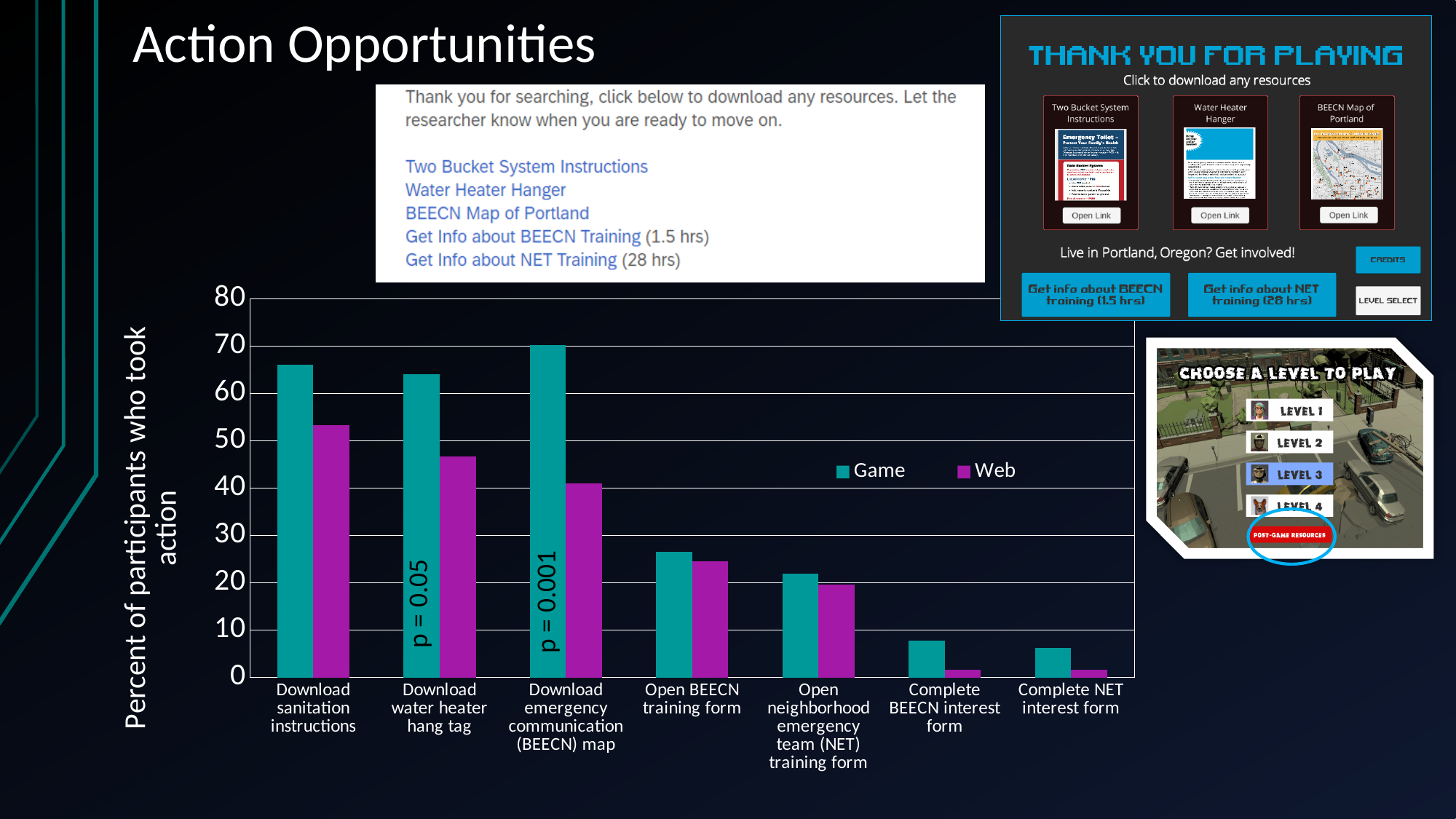
What is the label on the vertical axis of the chart? Percent of participants who took action Is the Game value for Open BEECN training form greater or less than 30? less Which category has the highest value for the Game series? Download emergency communication (BEECN) map What kind of chart is shown on the slide? bar chart Is the Web value for Complete BEECN interest form greater or less than 10? less How many action categories are shown along the x axis of the chart? 7 For Download sanitation instructions, which series has the larger value, Game or Web? Game How many series does the chart legend list? 2 Which category has the highest value for the Web series? Download sanitation instructions Is the Game value for Download sanitation instructions greater or less than 60? greater For Download water heater hang tag, which series has the larger value, Game or Web? Game